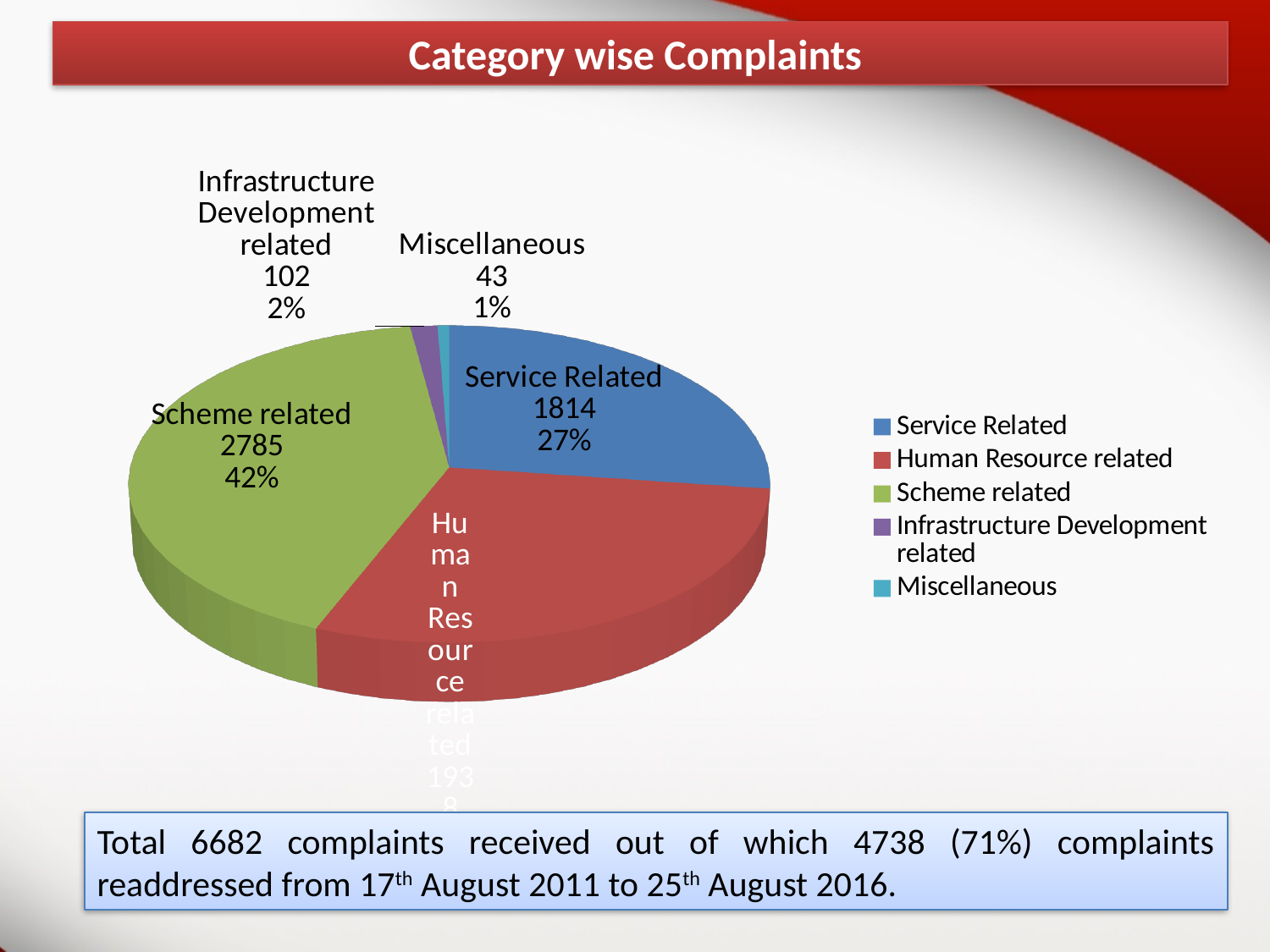
Which category has the largest slice of the pie? Scheme related What kind of chart is shown on the slide? pie chart What is the difference between the Scheme related and Service Related complaint counts? 971 What share of the pie does the Scheme related slice represent? 42% How many complaints are in the Service Related category? 1814 How many complaints are in the Infrastructure Development related category? 102 How many categories does the legend list? 5 What share of the pie does the Service Related slice represent? 27% How many complaints are in the Miscellaneous category? 43 Which has more complaints, Infrastructure Development related or Miscellaneous? Infrastructure Development related Which category has the smallest slice of the pie? Miscellaneous How many complaints are in the Scheme related category? 2785